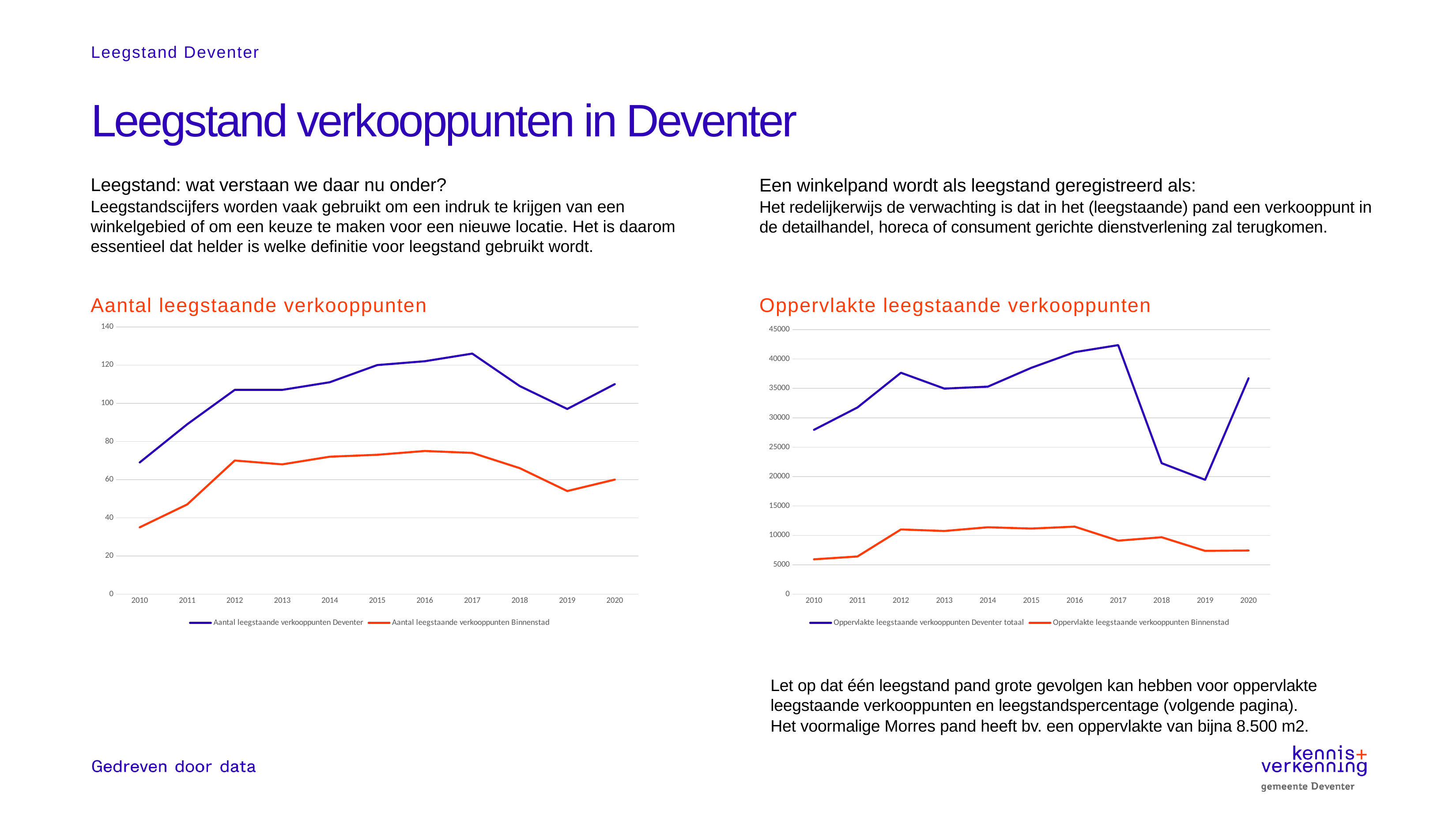
How many series does the legend of the 'Oppervlakte leegstaande verkooppunten' chart list? 2 In the 'Aantal leegstaande verkooppunten' chart, is the value for 'Aantal leegstaande verkooppunten Deventer' in 2017 greater or less than 120? greater How many years are shown on the x axis of the 'Aantal leegstaande verkooppunten' chart? 11 In the 'Aantal leegstaande verkooppunten' chart, in which year is the 'Aantal leegstaande verkooppunten Deventer' series highest? 2017 In the 'Oppervlakte leegstaande verkooppunten' chart, in which year is the 'Oppervlakte leegstaande verkooppunten Deventer totaal' series highest? 2017 What kind of chart is the 'Aantal leegstaande verkooppunten' chart? line chart In the 'Aantal leegstaande verkooppunten' chart, in which year is the 'Aantal leegstaande verkooppunten Binnenstad' series lowest? 2010 In the 'Oppervlakte leegstaande verkooppunten' chart, in which year is the 'Oppervlakte leegstaande verkooppunten Deventer totaal' series lowest? 2019 What colour is the 'Aantal leegstaande verkooppunten Binnenstad' line in the 'Aantal leegstaande verkooppunten' chart? orange In the 'Oppervlakte leegstaande verkooppunten' chart, does the 'Oppervlakte leegstaande verkooppunten Deventer totaal' series rise or fall from 2017 to 2019? fall In the 'Aantal leegstaande verkooppunten' chart, is the value for 'Aantal leegstaande verkooppunten Deventer' in 2010 greater or less than 80? less In the 'Oppervlakte leegstaande verkooppunten' chart, is the value for 'Oppervlakte leegstaande verkooppunten Binnenstad' in 2020 greater or less than 10000? less